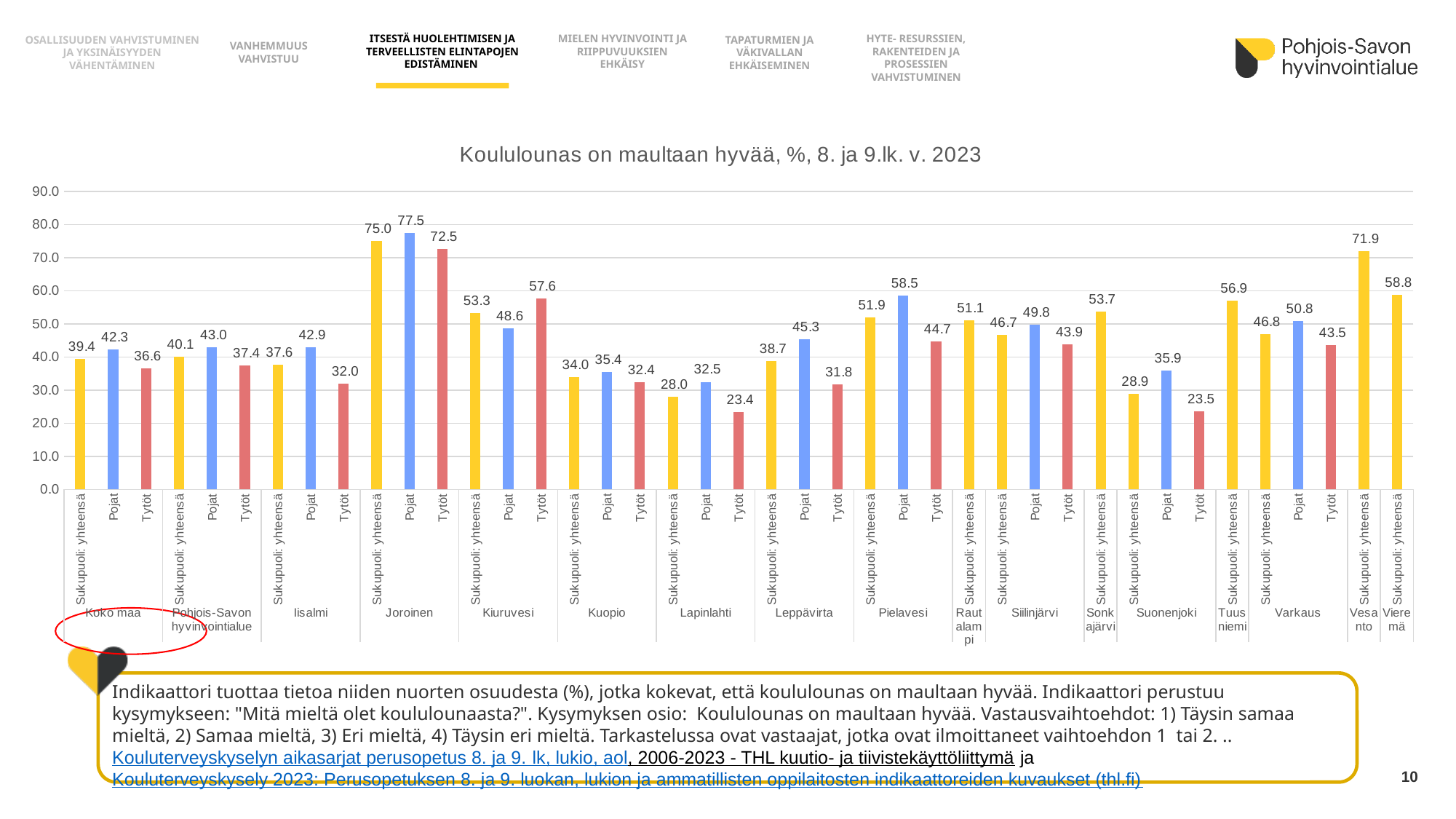
Which has the larger Sukupuoli: yhteensä value, Vesanto or Vieremä? Vesanto What is the value for Tytöt in Suonenjoki? 23.5 What is the difference between the Sukupuoli: yhteensä values for Pohjois-Savon hyvinvointialue and Koko maa? 0.7 What is the value for Sukupuoli: yhteensä in Kuopio? 34.0 How many areas (municipalities and regions) are shown on the x axis? 17 What is the value for Pojat in Pielavesi? 58.5 Which area has the highest value for Sukupuoli: yhteensä? Joroinen In Kiuruvesi, which is larger, the value for Pojat or for Tytöt? Tytöt Is the value for Sukupuoli: yhteensä in Vesanto greater or less than 70? greater What is the value for Pojat in Joroinen? 77.5 What is the difference between the Pojat and Tytöt values for Koko maa? 5.7 What kind of chart is shown on the slide? bar chart